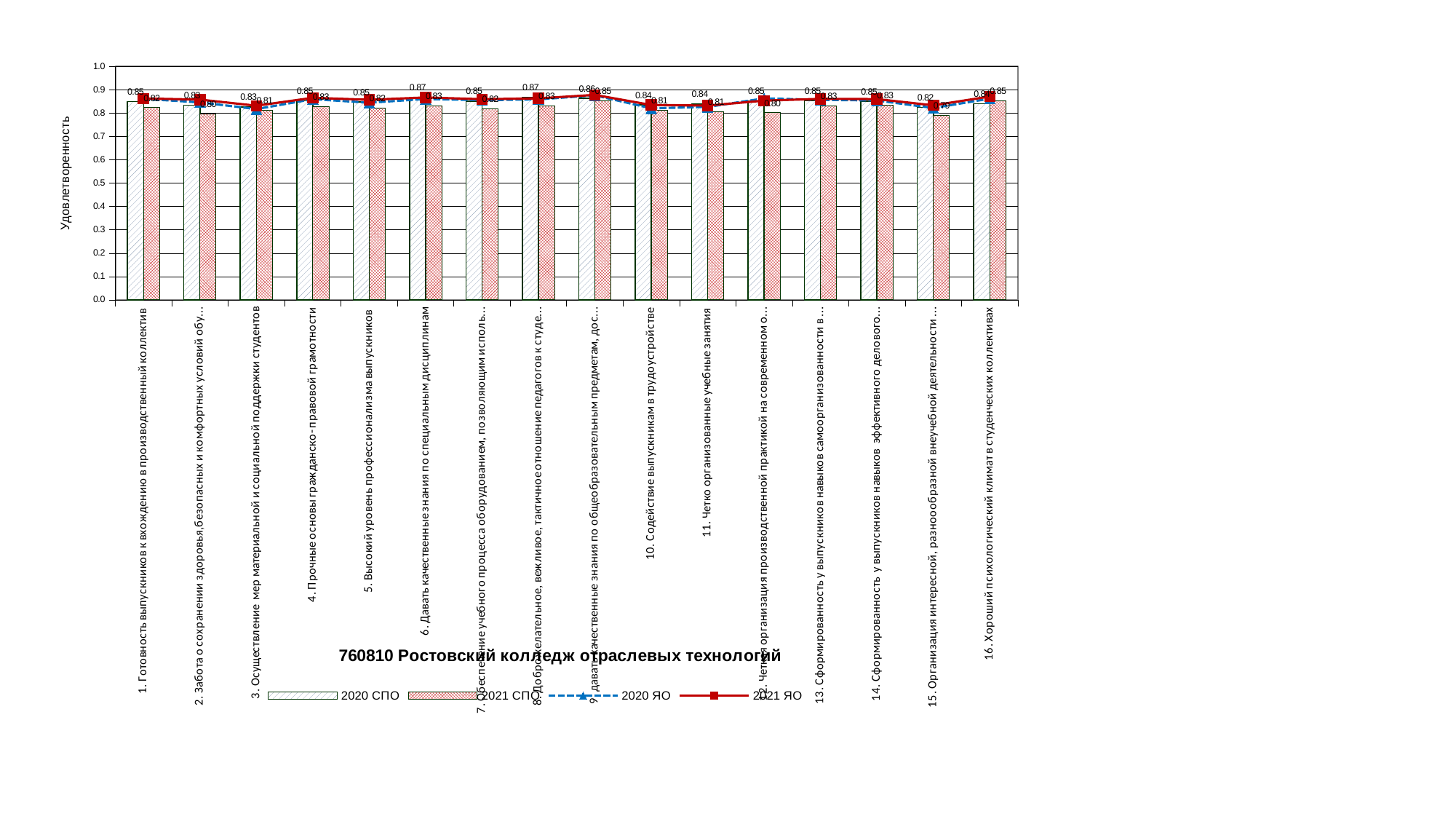
For category 15 (Организация интересной, разнообразной внеучебной деятельности...), which bar is taller: 2020 СПО or 2021 СПО? 2020 СПО What kind of chart is shown on the slide? Combined bar and line chart Is the 2021 ЯО value for category 10 (Содействие выпускникам в трудоустройстве) greater or less than 0.5? greater Is the 2020 СПО value for category 16 (Хороший психологический климат в студенческих коллективах) greater or less than 0.7? greater What is the label of the vertical axis? Удовлетворенность What is the highest tick value shown on the vertical axis? 1.0 For category 12 (Четкая организация производственной практикой...), which bar is taller: 2020 СПО or 2021 СПО? 2020 СПО How many series does the chart legend list? 4 Is the 2020 СПО value for category 1 (Готовность выпускников к вхождению в производственный коллектив) greater or less than 0.8? greater What is the title of the chart? 760810 Ростовский колледж отраслевых технологий How many categories are shown along the x axis of the chart? 16